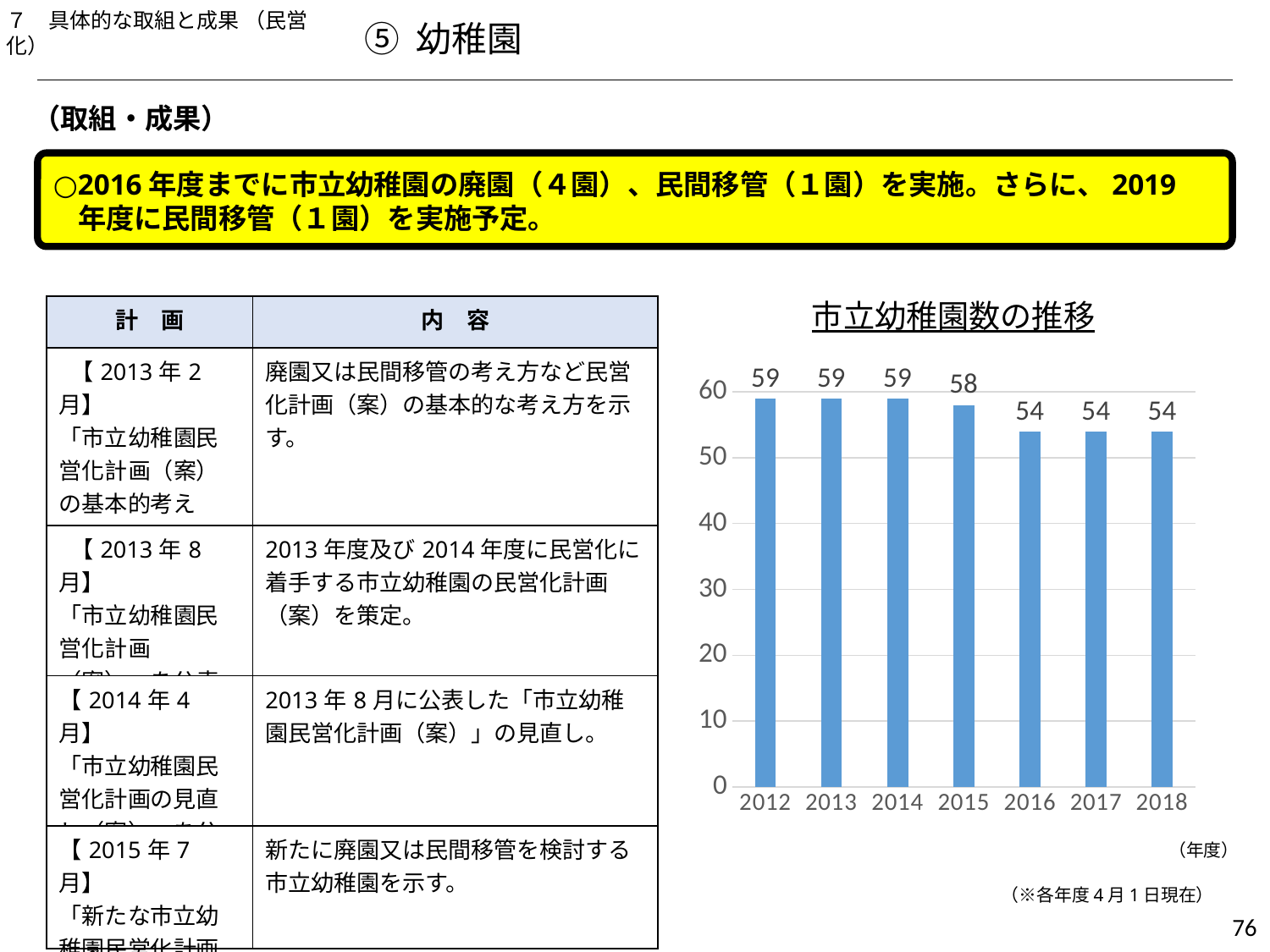
What is the value for 2015 in the 市立幼稚園数の推移 chart? 58 What kind of chart is the 市立幼稚園数の推移 chart? bar chart How many years are shown on the x axis of the 市立幼稚園数の推移 chart? 7 What is the difference between the values for 2015 and 2017 in the 市立幼稚園数の推移 chart? 4 What is the value for 2012 in the 市立幼稚園数の推移 chart? 59 What is the value for 2018 in the 市立幼稚園数の推移 chart? 54 Is the value for 2016 in the 市立幼稚園数の推移 chart greater or less than 60? less What is the difference between the values for 2014 and 2016 in the 市立幼稚園数の推移 chart? 5 Do the values in the 市立幼稚園数の推移 chart rise or fall from 2012 to 2018? fall Which is larger in the 市立幼稚園数の推移 chart, the value for 2013 or the value for 2015? 2013 Which year has the lowest value in the 市立幼稚園数の推移 chart, 2015 or 2016? 2016 What is the title of the chart on the slide? 市立幼稚園数の推移